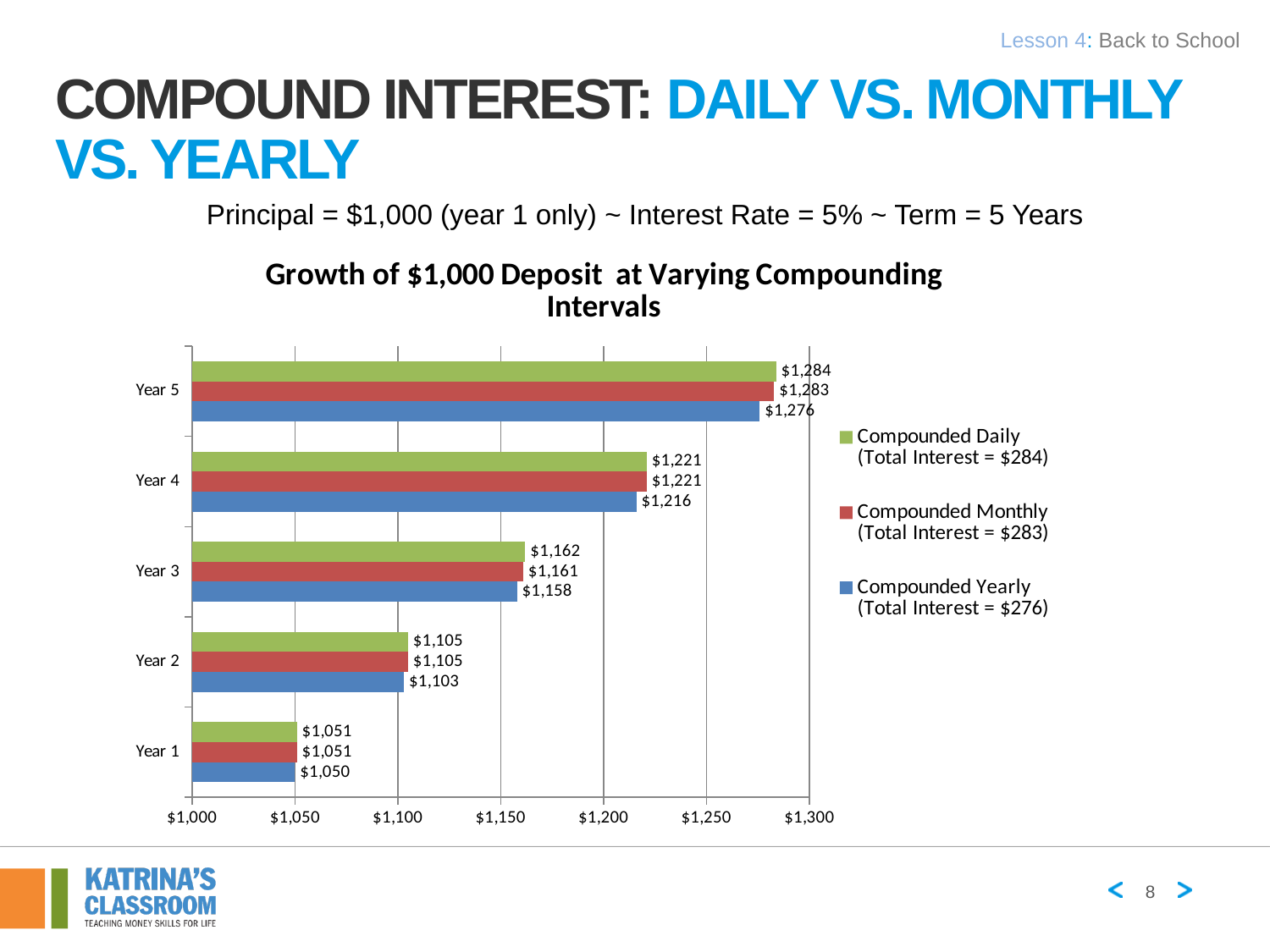
Which is larger in Year 4: the Compounded Daily value or the Compounded Yearly value? Compounded Daily What is the value for Compounded Yearly in Year 3? $1,158 Which year has the lowest value for Compounded Yearly? Year 1 How many years are shown on the chart? 5 Which year has the highest value for Compounded Daily? Year 5 What is the value for Compounded Daily in Year 5? $1,284 How many series does the legend list? 3 What is the value for Compounded Monthly in Year 2? $1,105 What is the difference between the Compounded Daily and Compounded Yearly values in Year 5? $8 What is the value for Compounded Yearly in Year 1? $1,050 What is the difference between the Compounded Monthly value in Year 4 and in Year 3? $60 What type of chart is shown on the slide? Bar chart